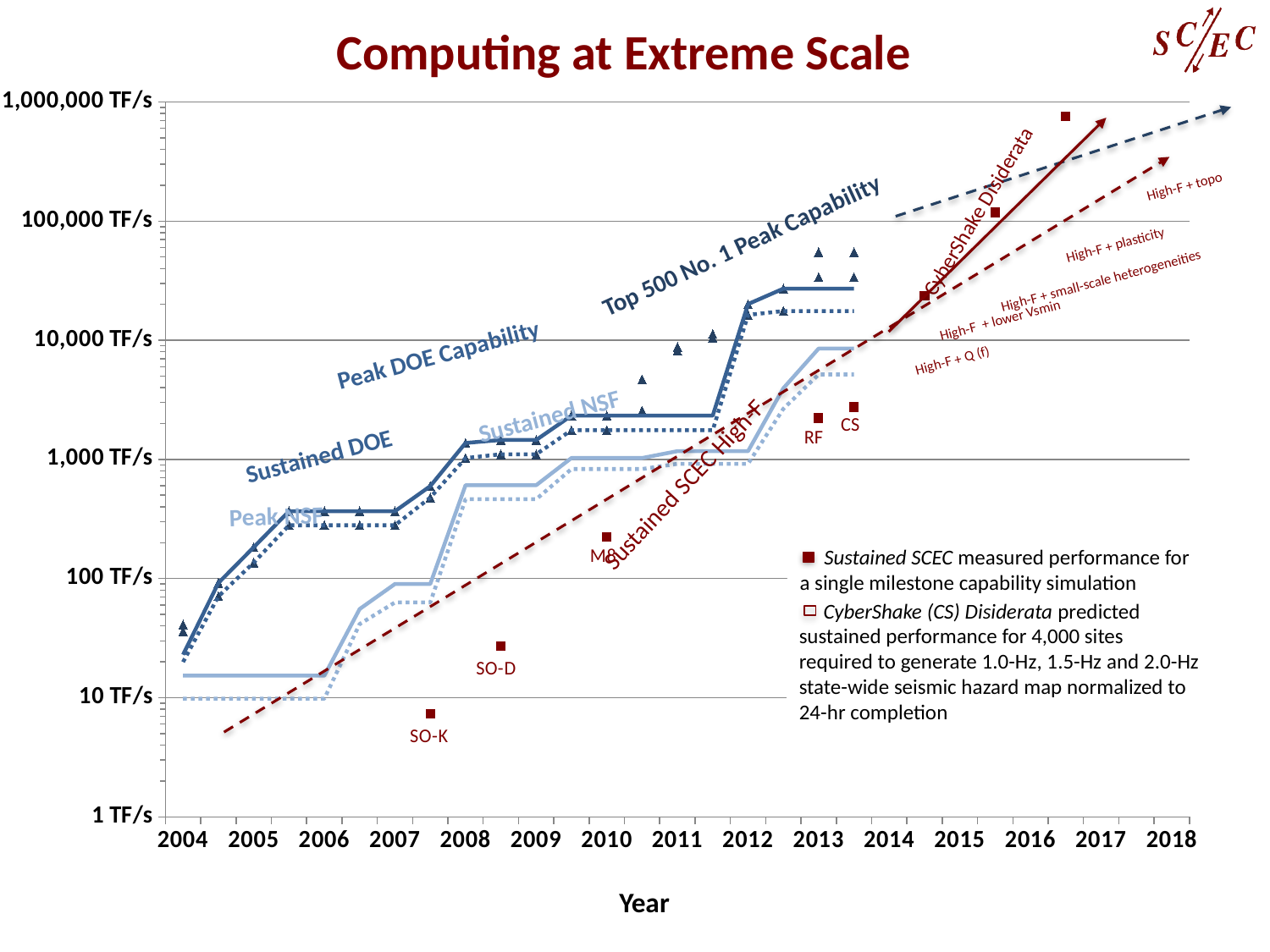
Is the value for the RF milestone greater or less than 1,000 TF/s? greater Is the value for the SO-D milestone greater or less than 10 TF/s? greater Is the value for the SO-K milestone greater or less than 10 TF/s? less Which of the labeled SCEC milestones, SO-K or SO-D, has the higher measured performance? SO-D Which labeled SCEC milestone has the lowest measured performance? SO-K What kind of chart is shown on the slide? line chart What is the title of the chart? Computing at Extreme Scale How many year ticks are shown on the x axis? 15 What is the label on the x axis of the chart? Year Does the Sustained DOE line rise or fall from 2004 to 2013? rise